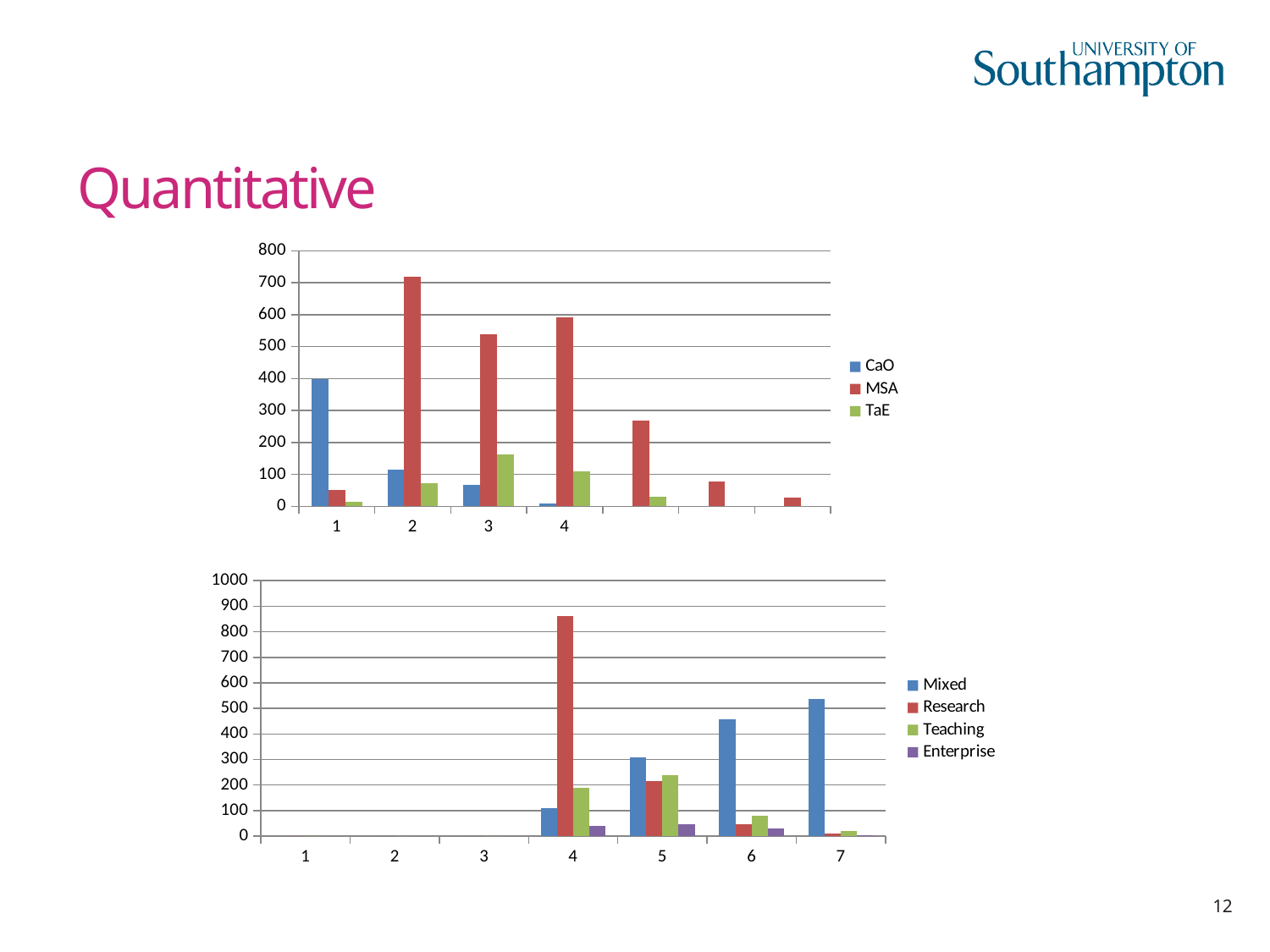
In the bottom chart, is the Research value for category 4 greater or less than 800? greater In the bottom chart, which is larger at category 5, Mixed or Research? Mixed What kind of chart is the top chart on the slide? bar chart In the top chart, at which category is the CaO bar highest? 1 In the top chart, which is larger at category 2, CaO or MSA? MSA In the bottom chart, at which category is the Mixed bar highest? 7 In the top chart, at which category is the MSA bar highest? 2 How many series does the legend of the top chart list? 3 In the top chart, is the MSA value for category 2 greater or less than 600? greater How many series does the legend of the bottom chart list? 4 In the top chart, is the CaO value for category 1 greater or less than 300? greater